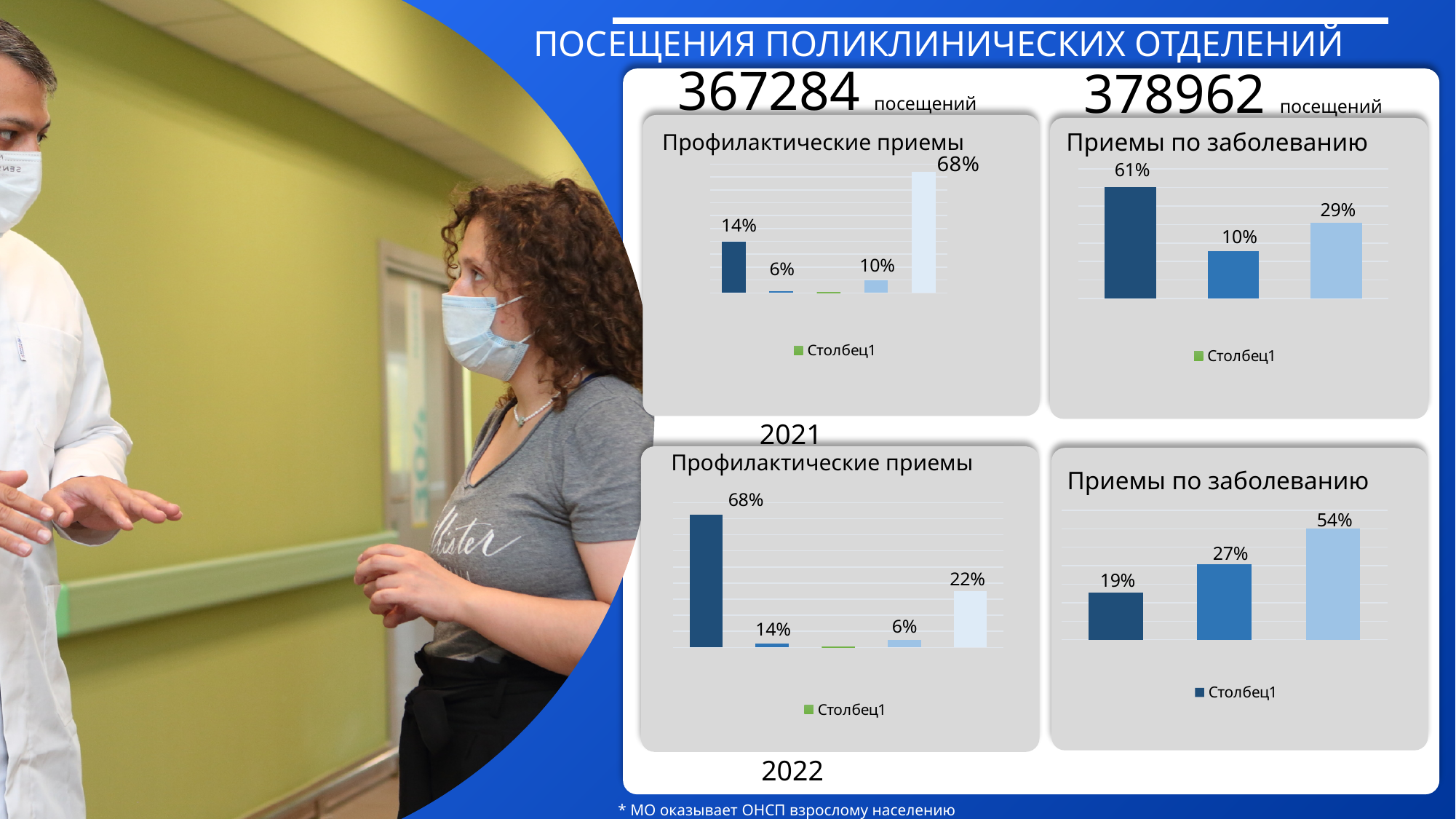
In the bottom-right chart 'Приемы по заболеванию' (2022), what is the difference between the rightmost bar and the leftmost bar? 35% In the bottom-left chart 'Профилактические приемы' (2022), which is larger: the leftmost bar or the rightmost bar? the leftmost bar (68%) What legend entry is shown under the top-left chart 'Профилактические приемы' (2021)? Столбец1 In the bottom-right chart 'Приемы по заболеванию' (2022), what is the value of the rightmost bar? 54% In the top-left chart 'Профилактические приемы' (2021), what is the value of the first (leftmost) bar? 14% In the top-right chart 'Приемы по заболеванию' (2021), what is the value of the first (leftmost) bar? 61% In the top-right chart 'Приемы по заболеванию' (2021), which bar has the lowest value? the middle bar (10%) In the top-left chart 'Профилактические приемы' (2021), what is the highest labelled value? 68% How many bars are plotted in the top-right chart 'Приемы по заболеванию' (2021)? 3 How many bars are plotted in the bottom-left chart 'Профилактические приемы' (2022)? 5 What type of chart is the bottom-right chart 'Приемы по заболеванию' (2022)? bar chart In the bottom-left chart 'Профилактические приемы' (2022), what is the value of the rightmost bar? 22%